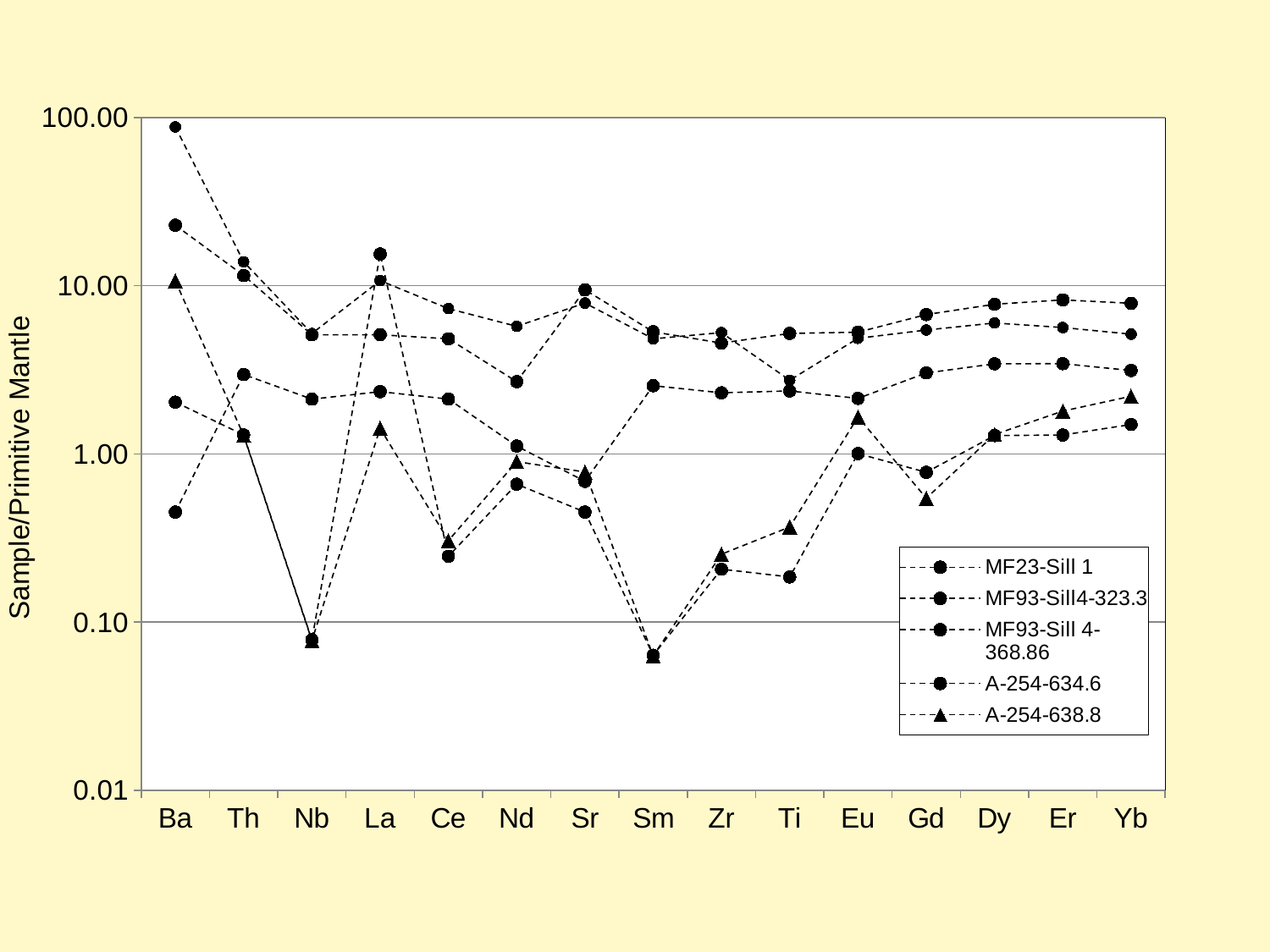
Is the value for A-254-638.8 at Sm greater or less than 0.10? less For the A-254-638.8 series, which is larger, the value at Yb or the value at Gd? Yb At which element does the highest plotted value on the chart occur? Ba What kind of chart is shown on the slide? line chart How many series does the legend list? 5 What is the label of the y axis? Sample/Primitive Mantle Is the value for A-254-638.8 at Ce greater or less than 1.00? less Is the value for A-254-638.8 at Yb greater or less than 1.00? greater Which series is plotted with triangle markers? A-254-638.8 How many elements are shown along the x axis? 15